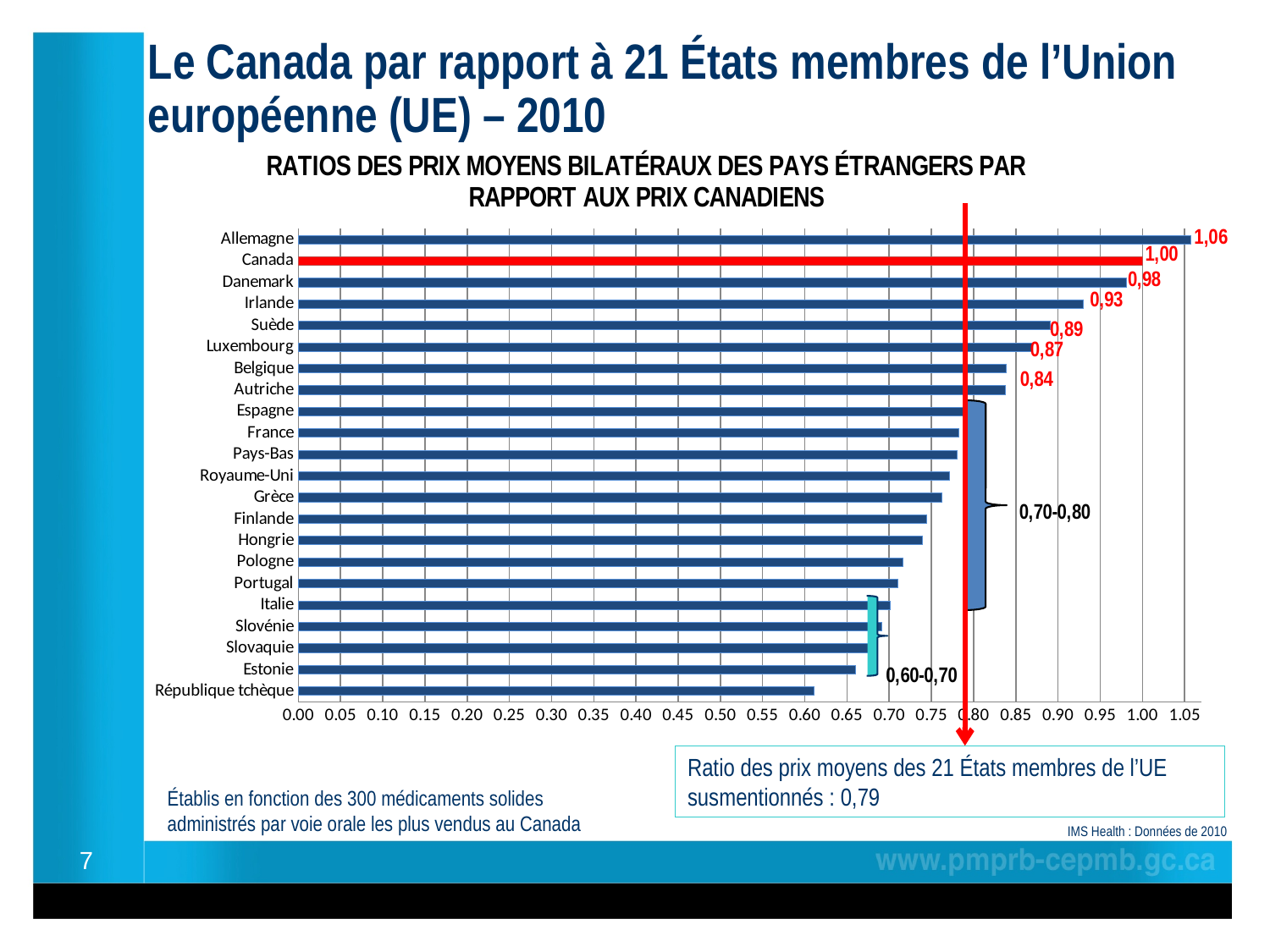
What kind of chart is shown on the slide? bar chart How many countries are shown in the chart? 22 Which country has the highest ratio? Allemagne What is the value for Suède? 0,89 What is the value for Irlande? 0,93 What is the value for Allemagne? 1,06 What is the difference between the values for Danemark and Irlande? 0,05 Is the value for Espagne greater or less than 0.75? greater Is the value for République tchèque greater or less than 0.65? less Which is larger, the value for Suède or the value for Luxembourg? Suède Which country has the lowest ratio? République tchèque What is the difference between the values for Allemagne and Canada? 0,06